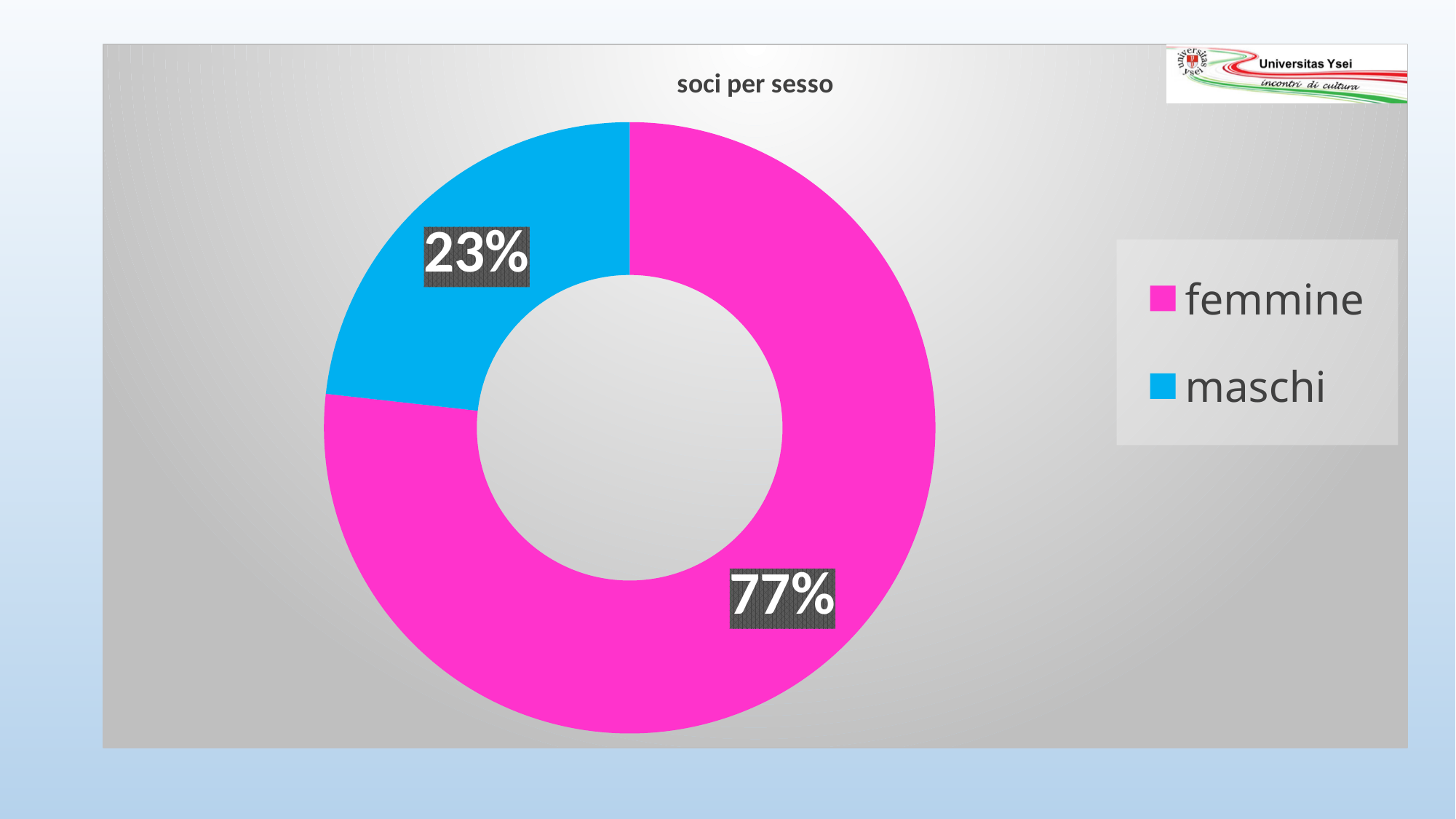
How many categories are shown in the chart? 2 What colour represents femmine in the chart? magenta (pink) How many entries does the legend list? 2 Which is larger, the share for femmine or the share for maschi? femmine What is the difference in percentage points between femmine and maschi? 54 Which category has the largest share of the chart? femmine What share of the chart does the maschi slice represent? 23% What kind of chart is shown on the slide? doughnut (pie) chart Which category has the smallest share of the chart? maschi What percentage of the chart is labelled for maschi? 23% What percentage of the chart is labelled for femmine? 77% What is the title of the chart? soci per sesso